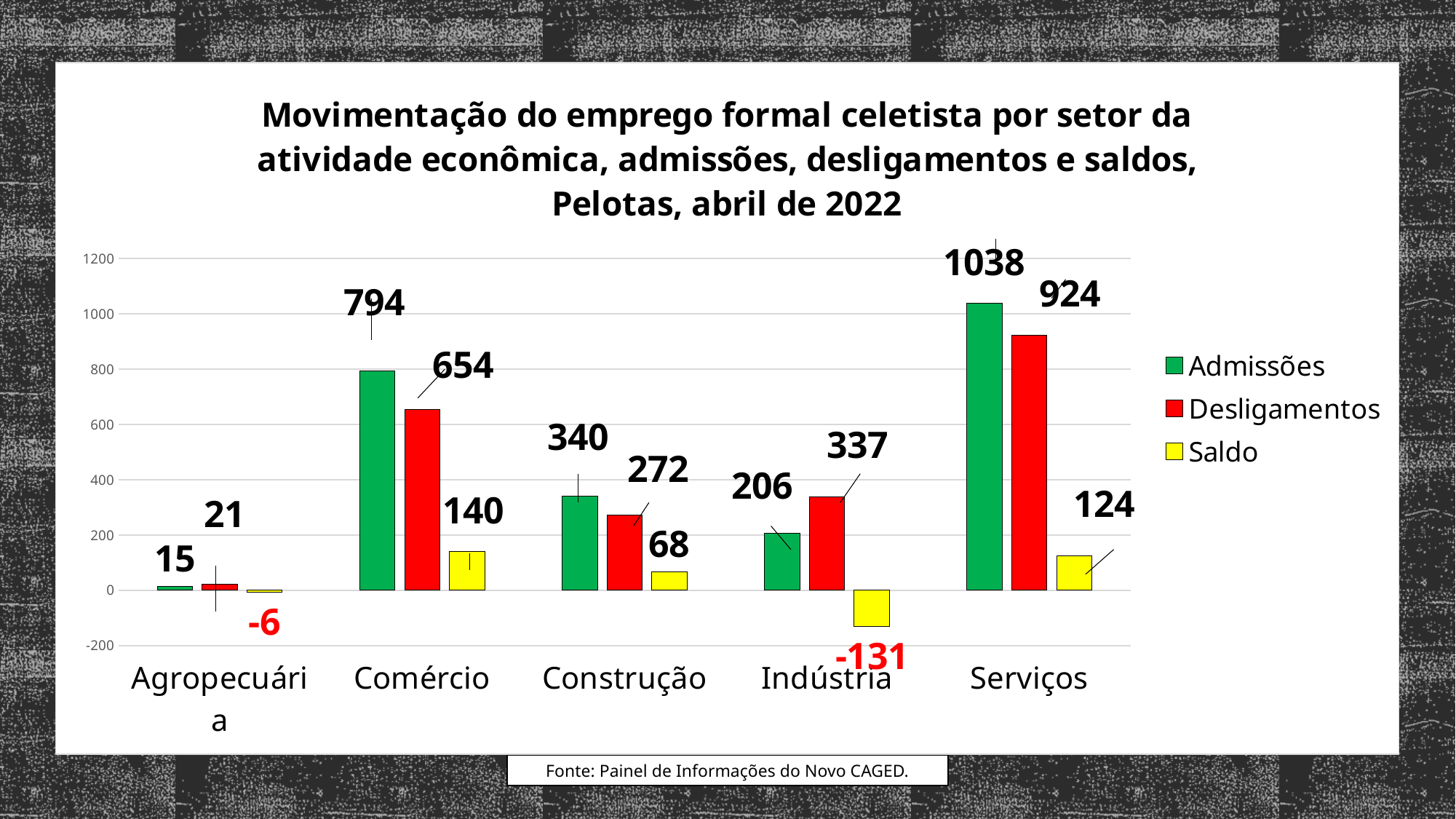
How many sectors are shown on the x axis? 5 How many series does the legend list? 3 What is the Saldo value for Indústria? -131 Which sector has the lowest Desligamentos value? Agropecuária What is the value of Admissões for Comércio? 794 What is the value of Desligamentos for Serviços? 924 Which sector has the highest Admissões value? Serviços What kind of chart is shown on the slide? Bar chart What is the difference between Admissões and Desligamentos for Construção? 68 What is the Saldo value for Agropecuária? -6 Which is larger for Indústria, Admissões or Desligamentos? Desligamentos What colour represents the Saldo series in the legend? Yellow